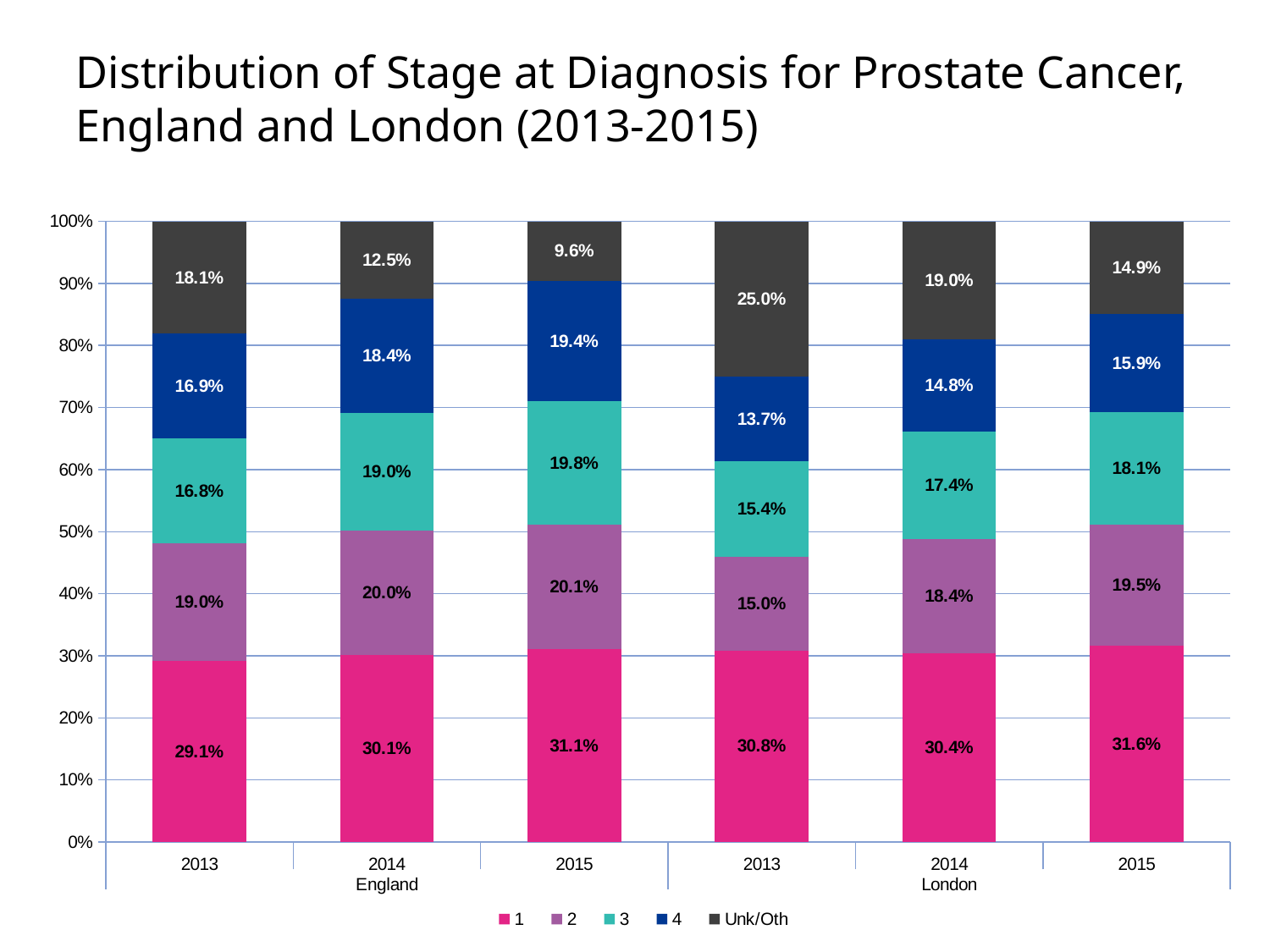
What is the stage 3 value for London in 2014? 17.4% What is the Unk/Oth share for London in 2013? 25.0% How many series does the legend list? 5 How many bars are plotted on the chart? 6 Which bar has the lowest Unk/Oth share? England 2015 Which bar has the highest Unk/Oth share? London 2013 What kind of chart is shown on the slide? Stacked bar chart Does the stage 1 share for England rise or fall from 2013 to 2015? Rise What is the difference between the stage 1 share for London 2015 and England 2013? 2.5% What percentage of prostate cancer diagnoses in England in 2013 were stage 1? 29.1% What is the stage 4 value for England in 2015? 19.4% Is the stage 2 share larger for England 2014 or London 2013? England 2014